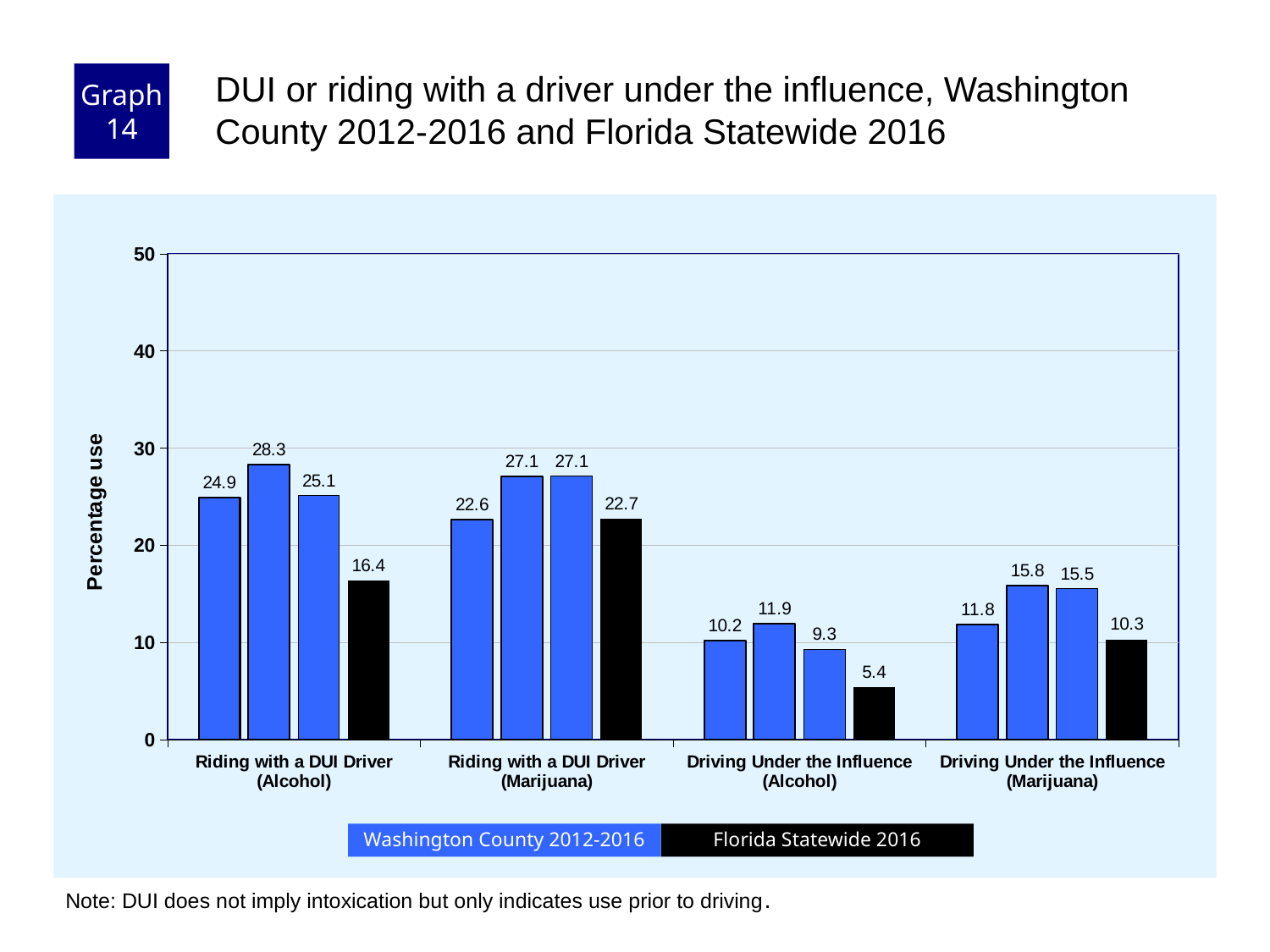
How many series does the legend list? 2 What kind of chart is shown on the slide? bar chart How many categories are shown on the x axis? 4 What is the label of the y axis? Percentage use Is the Florida Statewide 2016 value for Riding with a DUI Driver (Marijuana) greater or less than 20? greater Which has the larger Florida Statewide 2016 value: Driving Under the Influence (Marijuana) or Driving Under the Influence (Alcohol)? Driving Under the Influence (Marijuana) What is the Florida Statewide 2016 value for Riding with a DUI Driver (Alcohol)? 16.4 In which category is the Florida Statewide 2016 value lowest? Driving Under the Influence (Alcohol) What is the Florida Statewide 2016 value for Driving Under the Influence (Alcohol)? 5.4 What is the highest value shown on the chart? 28.3 What is the value of the tallest Washington County 2012-2016 bar in the Driving Under the Influence (Marijuana) category? 15.8 What is the difference between the Florida Statewide 2016 values for Riding with a DUI Driver (Marijuana) and Riding with a DUI Driver (Alcohol)? 6.3